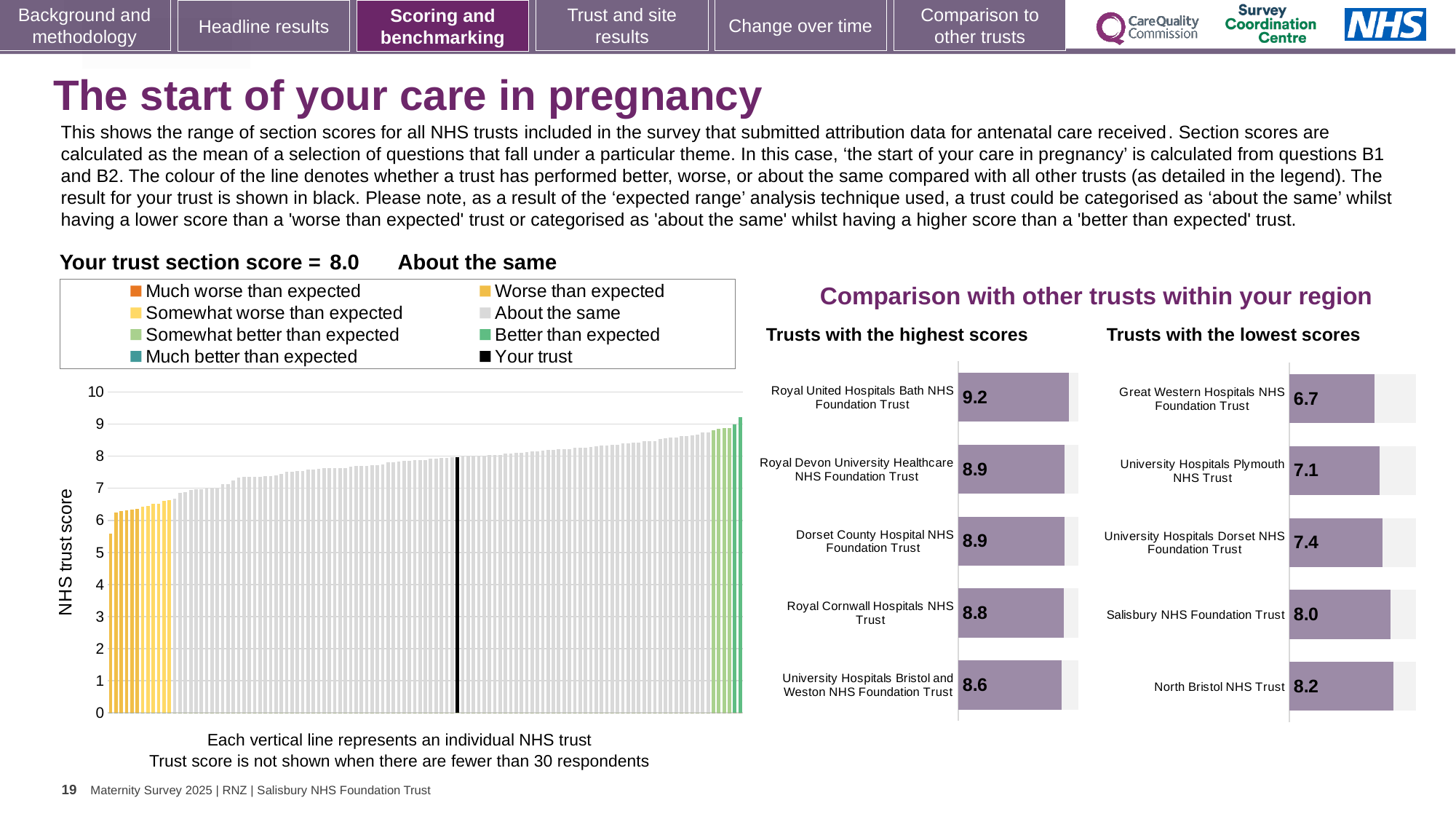
How many entries does the legend of the NHS trust score chart on the left list? 8 In the NHS trust score chart on the left, do the bar values rise or fall from left to right? rise In the 'Trusts with the lowest scores' chart, what is the score for University Hospitals Plymouth NHS Trust? 7.1 How many trusts are shown in the 'Trusts with the highest scores' chart? 5 In the 'Trusts with the highest scores' chart, which trust has the highest score? Royal United Hospitals Bath NHS Foundation Trust In the 'Trusts with the lowest scores' chart, which trust has the lowest score? Great Western Hospitals NHS Foundation Trust In the 'Trusts with the highest scores' chart, what is the score for Royal United Hospitals Bath NHS Foundation Trust? 9.2 In the 'Trusts with the highest scores' chart, what is the difference between the scores of Royal United Hospitals Bath NHS Foundation Trust and University Hospitals Bristol and Weston NHS Foundation Trust? 0.6 In the 'Trusts with the lowest scores' chart, which has the higher score: Salisbury NHS Foundation Trust or University Hospitals Dorset NHS Foundation Trust? Salisbury NHS Foundation Trust In the NHS trust score chart on the left, is the value of the leftmost bar greater or less than 6? less In the NHS trust score chart on the left, what is the section score for your trust (the black bar)? 8.0 In the 'Trusts with the lowest scores' chart, what is the difference between the scores of North Bristol NHS Trust and Great Western Hospitals NHS Foundation Trust? 1.5